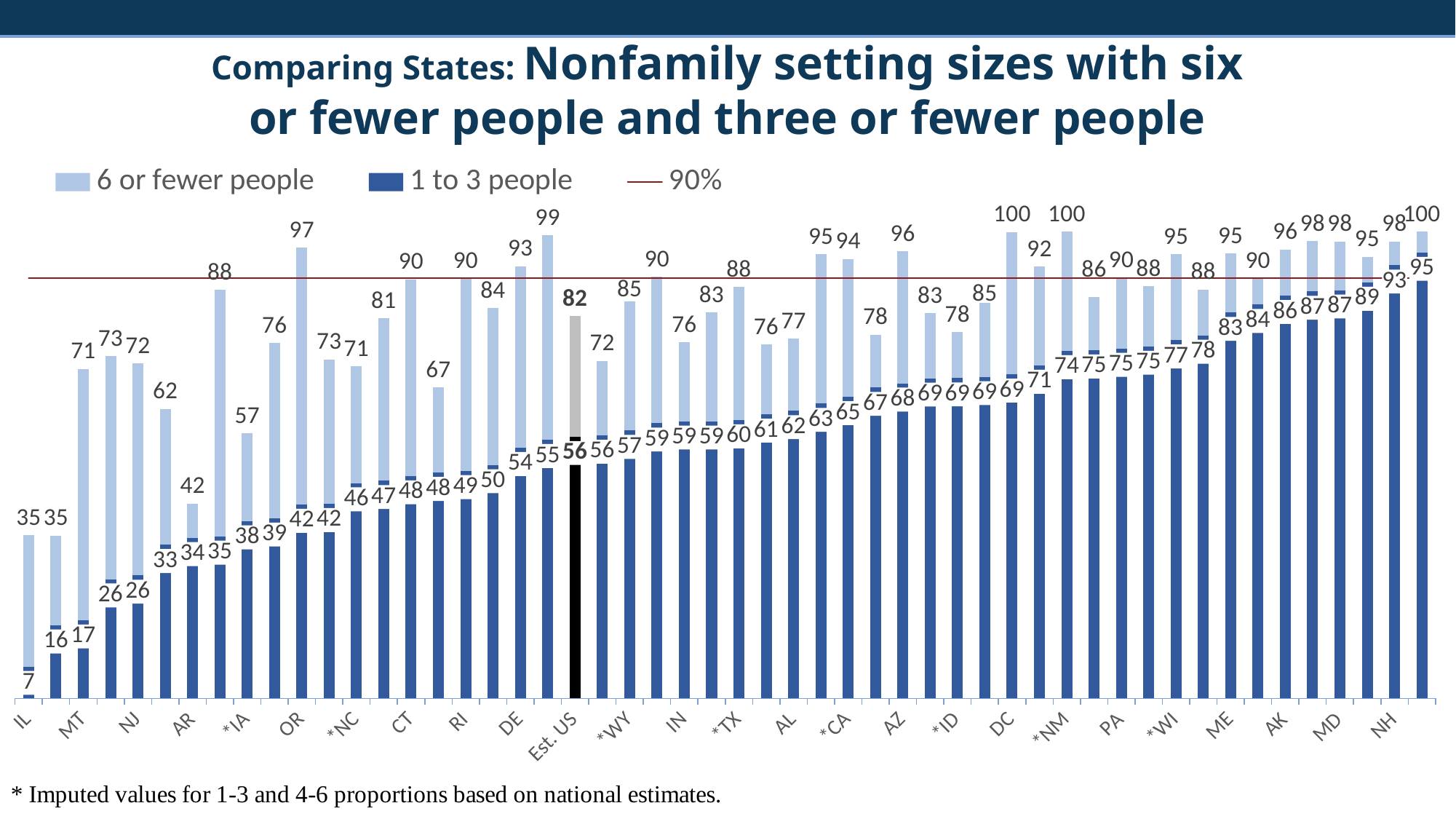
What is the value for '6 or fewer people' for Est. US? 82 What is the value for '6 or fewer people' for OR? 97 What is the value for '1 to 3 people' for NH? 93 How many entries does the legend list? 3 What value does the horizontal reference line in the legend represent? 90% What is the value for '1 to 3 people' for IL? 7 Which is larger, the '6 or fewer people' value for CT or for AR? CT What kind of chart is shown on the slide? Bar chart What is the value for '1 to 3 people' for Est. US? 56 What is the difference between the '6 or fewer people' and '1 to 3 people' values for Est. US? 26 What is the value for '6 or fewer people' for DC? 100 Which state has the lowest value for '1 to 3 people'? IL